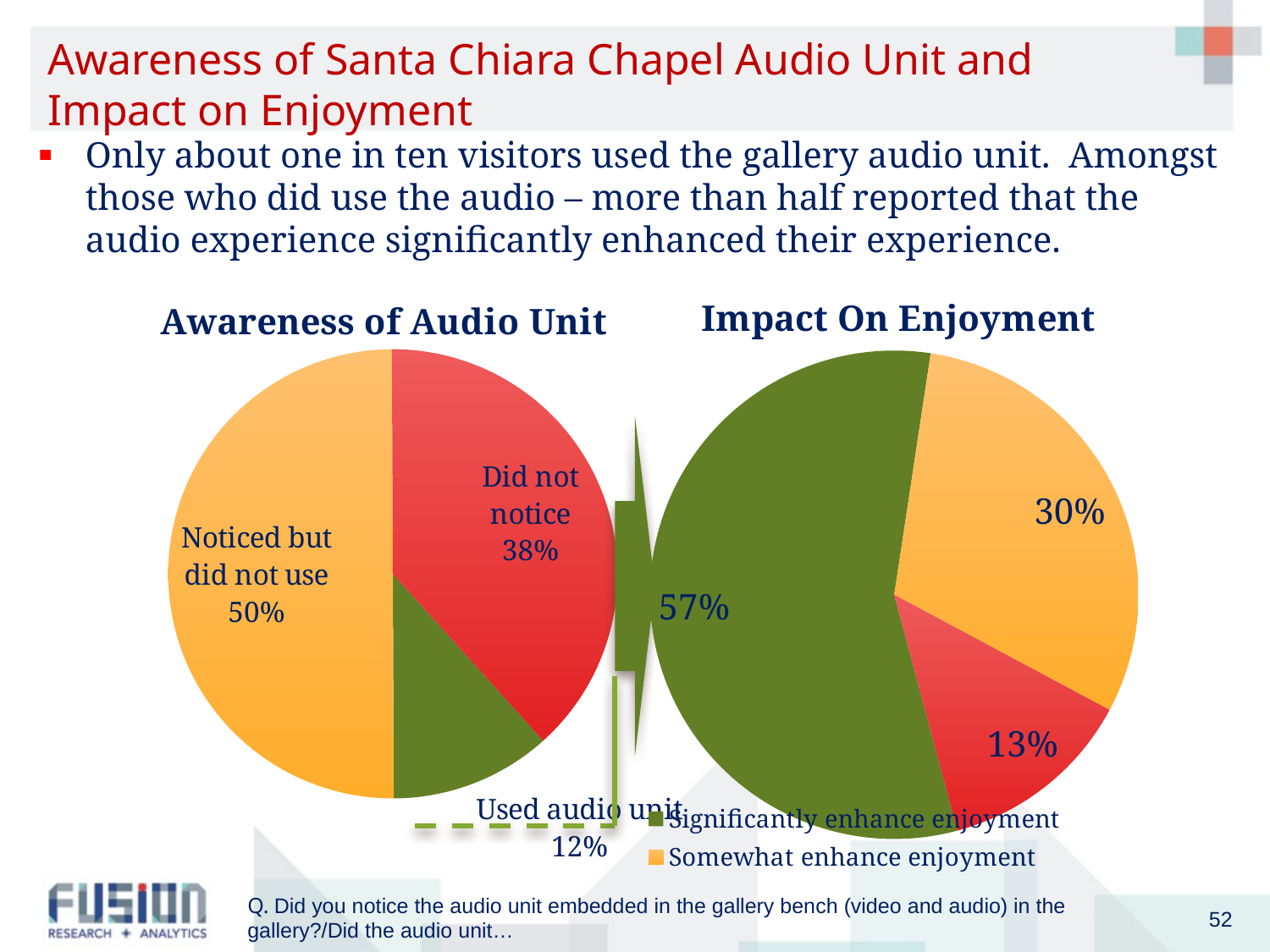
In the 'Awareness of Audio Unit' chart, what share of visitors used the audio unit? 12% How many slices does the 'Awareness of Audio Unit' pie chart have? 3 In the 'Impact On Enjoyment' chart, which is larger: 'Significantly enhance enjoyment' or 'Somewhat enhance enjoyment'? Significantly enhance enjoyment In the 'Awareness of Audio Unit' chart, what share of visitors noticed but did not use the audio unit? 50% In the 'Awareness of Audio Unit' chart, which category has the largest share? Noticed but did not use In the 'Awareness of Audio Unit' chart, which category has the smallest share? Used audio unit In the 'Impact On Enjoyment' chart, what share said the audio unit somewhat enhanced their enjoyment? 30% In the 'Impact On Enjoyment' chart, what is the difference between the 'Significantly enhance enjoyment' share and the 'Somewhat enhance enjoyment' share? 27% In the 'Impact On Enjoyment' chart, what share said the audio unit significantly enhanced their enjoyment? 57% What kind of chart is the 'Awareness of Audio Unit' chart? pie chart In the 'Awareness of Audio Unit' chart, what share of visitors did not notice the audio unit? 38% In the 'Awareness of Audio Unit' chart, what is the difference between the 'Noticed but did not use' share and the 'Did not notice' share? 12%